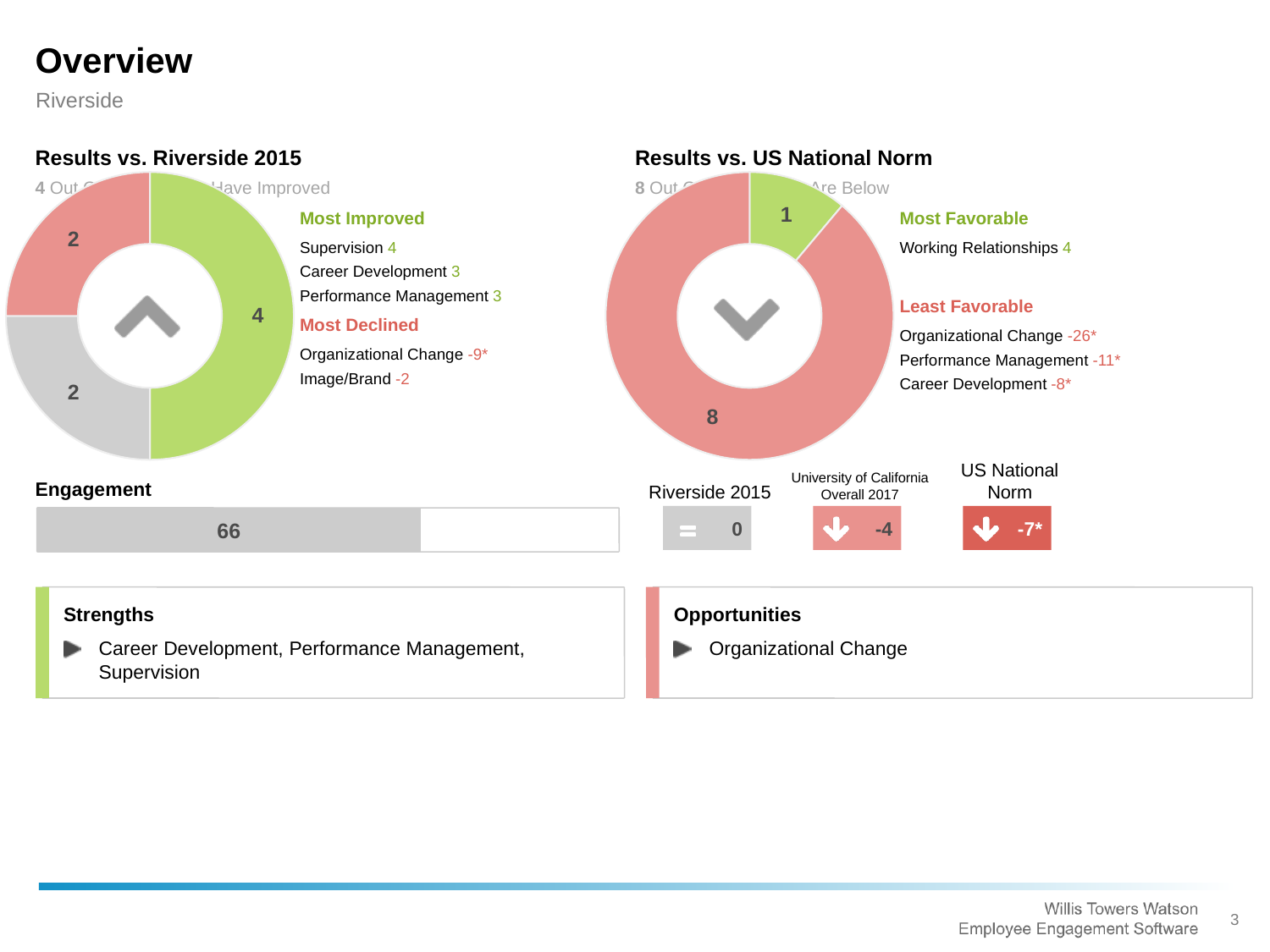
On the 'Results vs. US National Norm' chart, which is larger, the red slice or the green slice? The red slice On the 'Results vs. US National Norm' chart, what is the difference between the red slice and the green slice? 7 On the 'Results vs. Riverside 2015' chart, what value is shown on the green slice? 4 On the 'Results vs. US National Norm' chart, what value is shown on the green slice? 1 On the 'Results vs. Riverside 2015' chart, which slice has the largest value? The green slice (4) On the 'Results vs. US National Norm' chart, what value is shown on the red slice? 8 On the 'Results vs. Riverside 2015' chart, what is the difference between the green slice and the red slice? 2 On the 'Results vs. Riverside 2015' chart, what share of the total does the green slice (4) represent? 50% On the 'Results vs. Riverside 2015' chart, what is the total of all slice values? 8 What kind of chart is used for 'Results vs. US National Norm'? Donut (pie) chart How many slices does the 'Results vs. Riverside 2015' chart have? 3 On the 'Results vs. US National Norm' chart, which slice has the smallest value? The green slice (1)